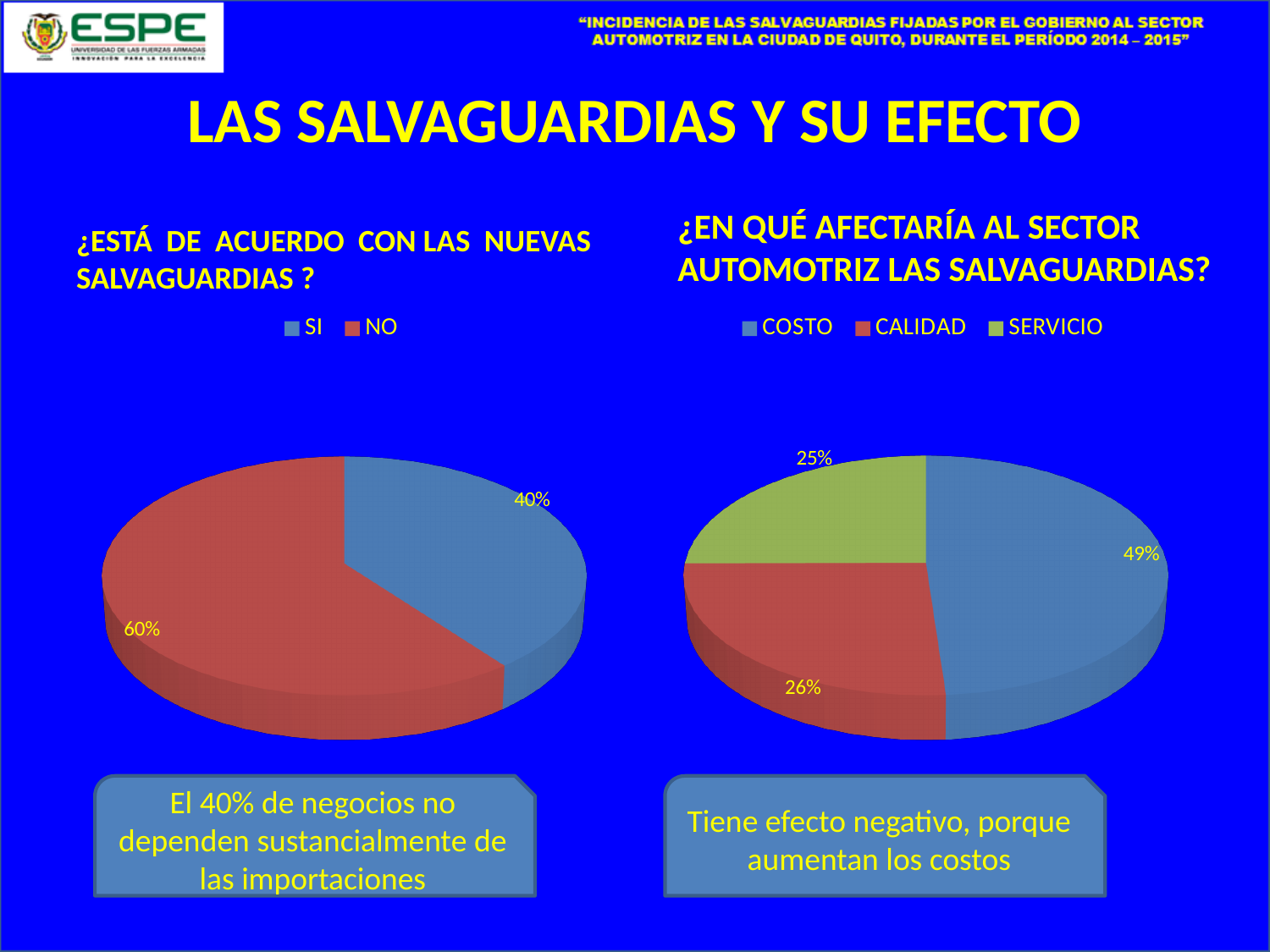
In the right pie chart (¿EN QUÉ AFECTARÍA AL SECTOR AUTOMOTRIZ LAS SALVAGUARDIAS?), which category has the largest slice? COSTO In the left pie chart (¿ESTÁ DE ACUERDO CON LAS NUEVAS SALVAGUARDIAS?), which category has the largest slice? NO In the right pie chart (¿EN QUÉ AFECTARÍA AL SECTOR AUTOMOTRIZ LAS SALVAGUARDIAS?), what share is labelled for CALIDAD? 26% In the left pie chart (¿ESTÁ DE ACUERDO CON LAS NUEVAS SALVAGUARDIAS?), how many categories does the legend list? 2 In the left pie chart (¿ESTÁ DE ACUERDO CON LAS NUEVAS SALVAGUARDIAS?), what share is labelled for SI? 40% In the right pie chart (¿EN QUÉ AFECTARÍA AL SECTOR AUTOMOTRIZ LAS SALVAGUARDIAS?), what is the difference in percentage points between COSTO and CALIDAD? 23 In the left pie chart (¿ESTÁ DE ACUERDO CON LAS NUEVAS SALVAGUARDIAS?), what share is labelled for NO? 60% In the right pie chart (¿EN QUÉ AFECTARÍA AL SECTOR AUTOMOTRIZ LAS SALVAGUARDIAS?), how many categories does the legend list? 3 What type of chart is used on the left side of the slide? Pie chart In the right pie chart (¿EN QUÉ AFECTARÍA AL SECTOR AUTOMOTRIZ LAS SALVAGUARDIAS?), what share is labelled for SERVICIO? 25% In the right pie chart (¿EN QUÉ AFECTARÍA AL SECTOR AUTOMOTRIZ LAS SALVAGUARDIAS?), what share is labelled for COSTO? 49% In the left pie chart (¿ESTÁ DE ACUERDO CON LAS NUEVAS SALVAGUARDIAS?), what is the difference in percentage points between NO and SI? 20